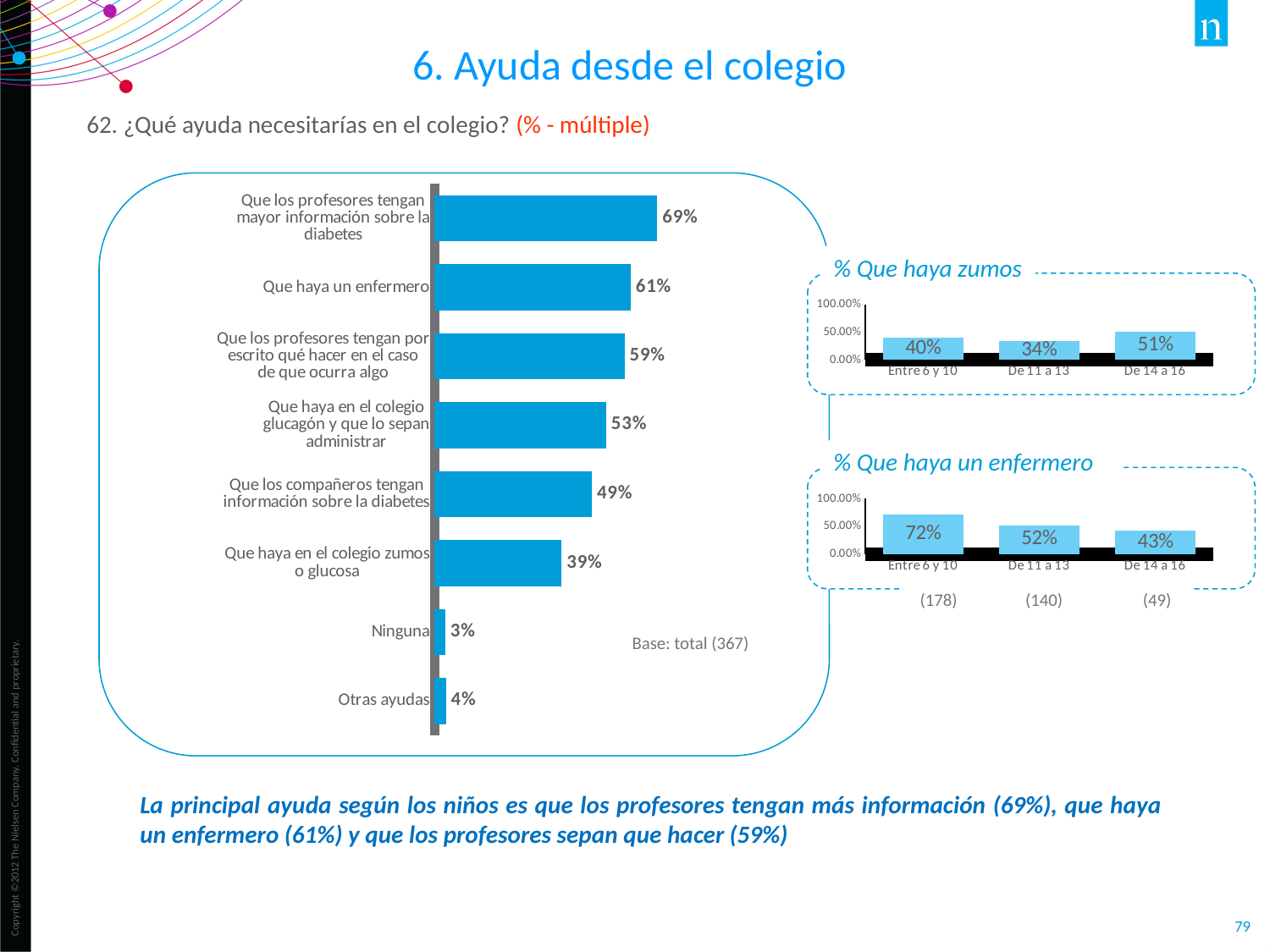
In the main horizontal bar chart on the left, what is the difference between 'Que los profesores tengan mayor información sobre la diabetes' and 'Que haya en el colegio zumos o glucosa'? 30% In the '% Que haya zumos' chart, is the value for 'De 14 a 16' larger or smaller than the value for 'De 11 a 13'? Larger In the '% Que haya zumos' chart, which age group has the highest value? De 14 a 16 In the main horizontal bar chart on the left, how many categories are shown? 8 In the main horizontal bar chart on the left, what is the value for 'Que haya un enfermero'? 61% In the '% Que haya un enfermero' chart, what is the value for 'Entre 6 y 10'? 72% In the main horizontal bar chart on the left, which category has the lowest value? Ninguna In the '% Que haya un enfermero' chart, what is the difference between 'Entre 6 y 10' and 'De 14 a 16'? 29% In the main horizontal bar chart on the left, which category has the highest value? Que los profesores tengan mayor información sobre la diabetes In the '% Que haya un enfermero' chart, do the values rise or fall from 'Entre 6 y 10' to 'De 14 a 16'? Fall What kind of chart is the main chart on the left? Bar chart In the '% Que haya zumos' chart, what is the value for 'De 11 a 13'? 34%